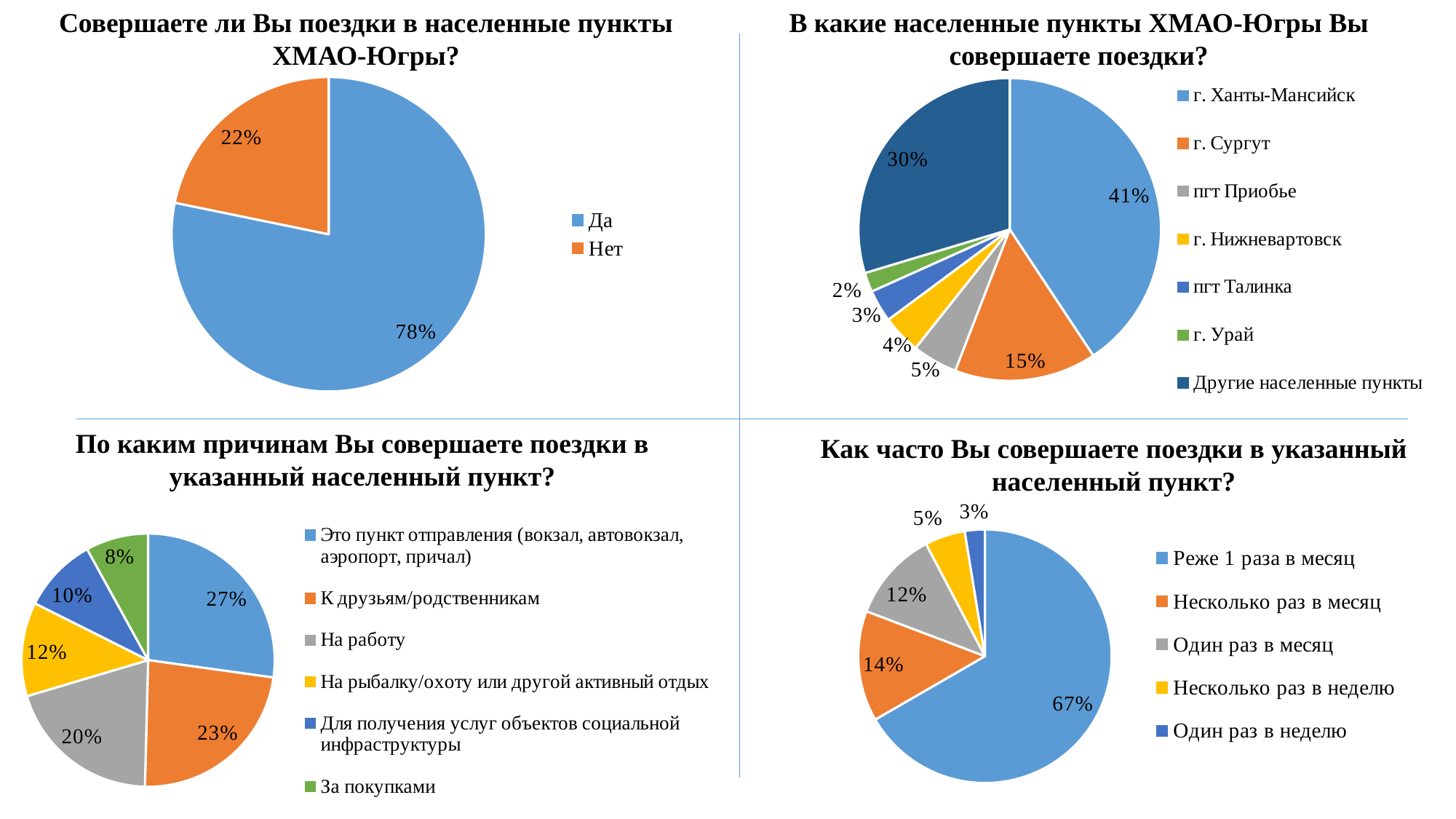
In the bottom-right chart 'Как часто Вы совершаете поездки в указанный населенный пункт?', what share is shown for 'Реже 1 раза в месяц'? 67% What type of chart is used in the bottom-right chart 'Как часто Вы совершаете поездки в указанный населенный пункт?'? Pie chart How many categories does the legend of the top-right chart 'В какие населенные пункты ХМАО-Югры Вы совершаете поездки?' list? 7 In the bottom-left chart 'По каким причинам Вы совершаете поездки в указанный населенный пункт?', which category has the smallest share? За покупками In the bottom-left chart 'По каким причинам Вы совершаете поездки в указанный населенный пункт?', what share is shown for 'На работу'? 20% In the bottom-right chart 'Как часто Вы совершаете поездки в указанный населенный пункт?', what is the difference between 'Несколько раз в месяц' and 'Один раз в месяц'? 2% In the top-left chart 'Совершаете ли Вы поездки в населенные пункты ХМАО-Югры?', what share of respondents answered 'Да'? 78% In the top-right chart 'В какие населенные пункты ХМАО-Югры Вы совершаете поездки?', which category has the largest share? г. Ханты-Мансийск In the top-left chart 'Совершаете ли Вы поездки в населенные пункты ХМАО-Югры?', what is the difference between the 'Да' and 'Нет' shares? 56% In the bottom-left chart 'По каким причинам Вы совершаете поездки в указанный населенный пункт?', which is larger: 'К друзьям/родственникам' or 'На рыбалку/охоту или другой активный отдых'? К друзьям/родственникам In the top-right chart 'В какие населенные пункты ХМАО-Югры Вы совершаете поездки?', what share is shown for 'г. Сургут'? 15% In the top-right chart 'В какие населенные пункты ХМАО-Югры Вы совершаете поездки?', which category has the smallest share? г. Урай